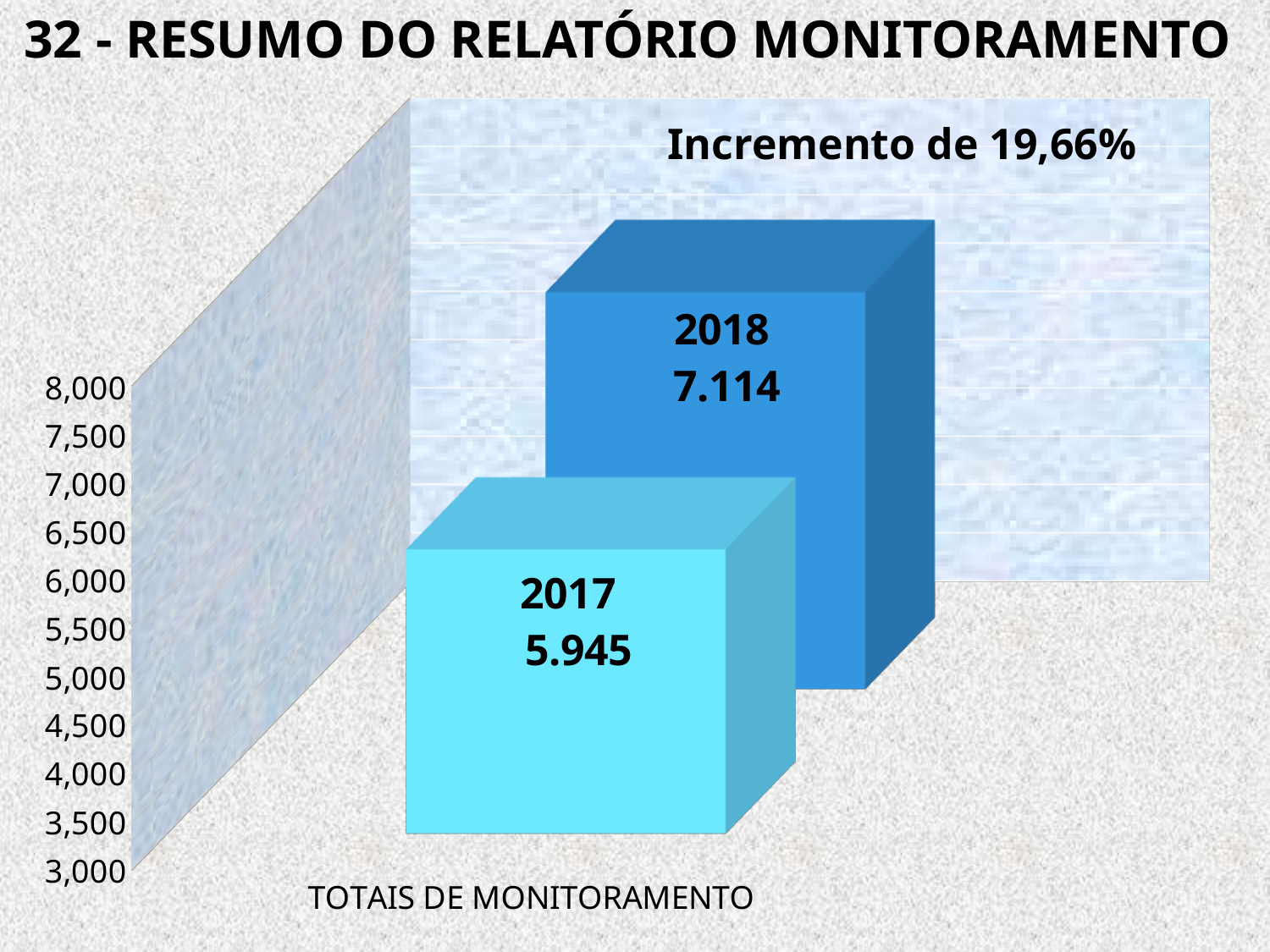
Which year has the higher value? 2018 What kind of chart is shown on the slide? bar chart Is the value for 2018 greater or less than 7,500? less Do the values rise or fall from 2017 to 2018? rise What percentage increase is stated on the chart? 19,66% What is the value shown for 2018? 7.114 What is the value shown for 2017? 5.945 How many bars are plotted in the chart? 2 What is the difference between the 2018 value and the 2017 value? 1.169 Is the value for 2018 larger or smaller than the value for 2017? larger Which year has the lower value? 2017 Is the value for 2017 greater or less than 5,000? greater